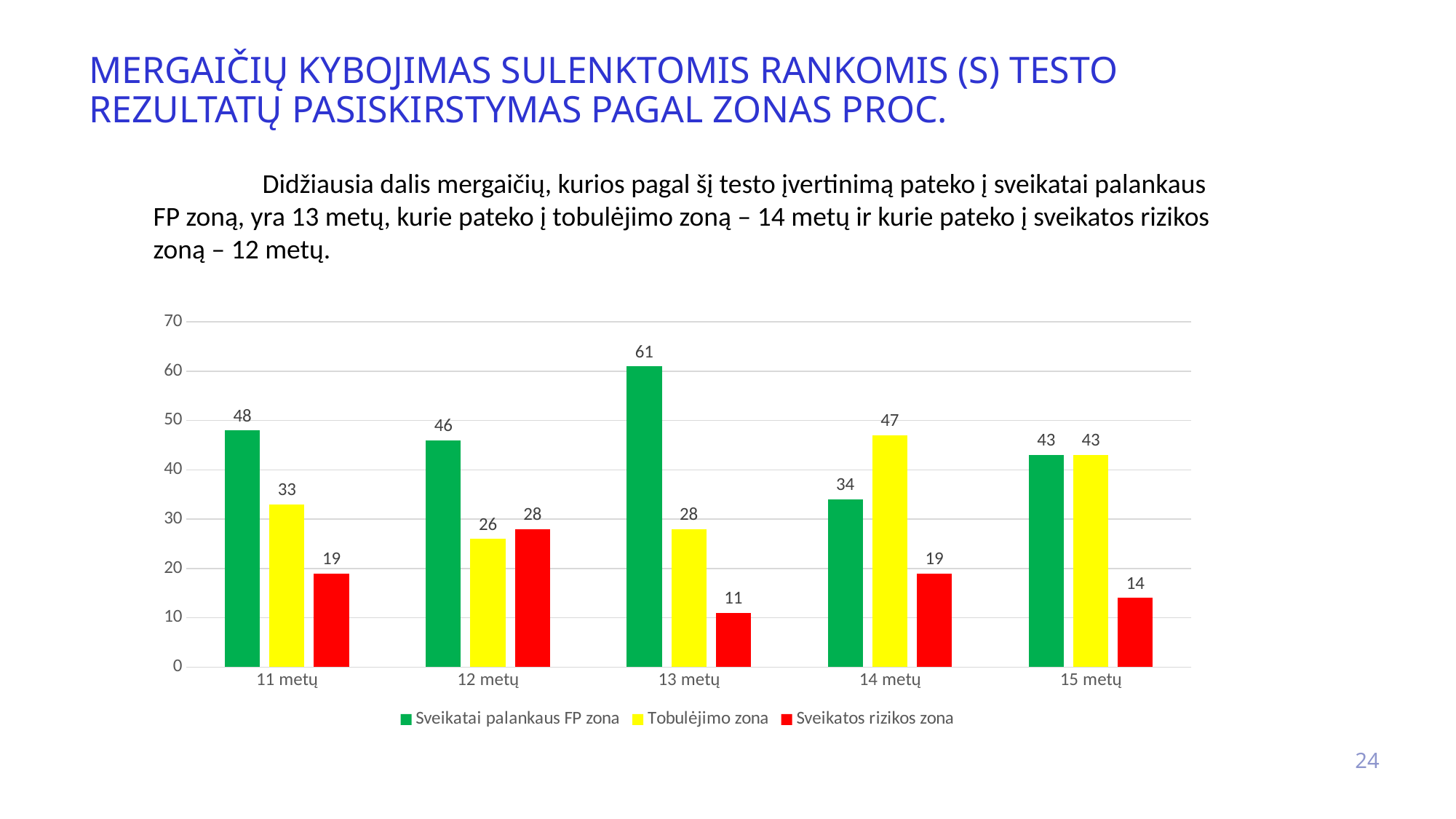
Which age group has the lowest value for Sveikatos rizikos zona? 13 metų What is the value for Sveikatos rizikos zona at 12 metų? 28 How many series does the legend list? 3 Is the value for Sveikatai palankaus FP zona at 14 metų greater or less than 40? less Which colour represents Tobulėjimo zona in the chart? yellow What is the value for Tobulėjimo zona at 14 metų? 47 What kind of chart is shown on the slide? bar chart Which is larger at 12 metų: Tobulėjimo zona or Sveikatos rizikos zona? Sveikatos rizikos zona Which age group has the highest value for Sveikatai palankaus FP zona? 13 metų How many age groups are shown on the x axis? 5 What is the difference between the Sveikatai palankaus FP zona and Tobulėjimo zona values at 11 metų? 15 What is the value for Sveikatai palankaus FP zona at 13 metų? 61